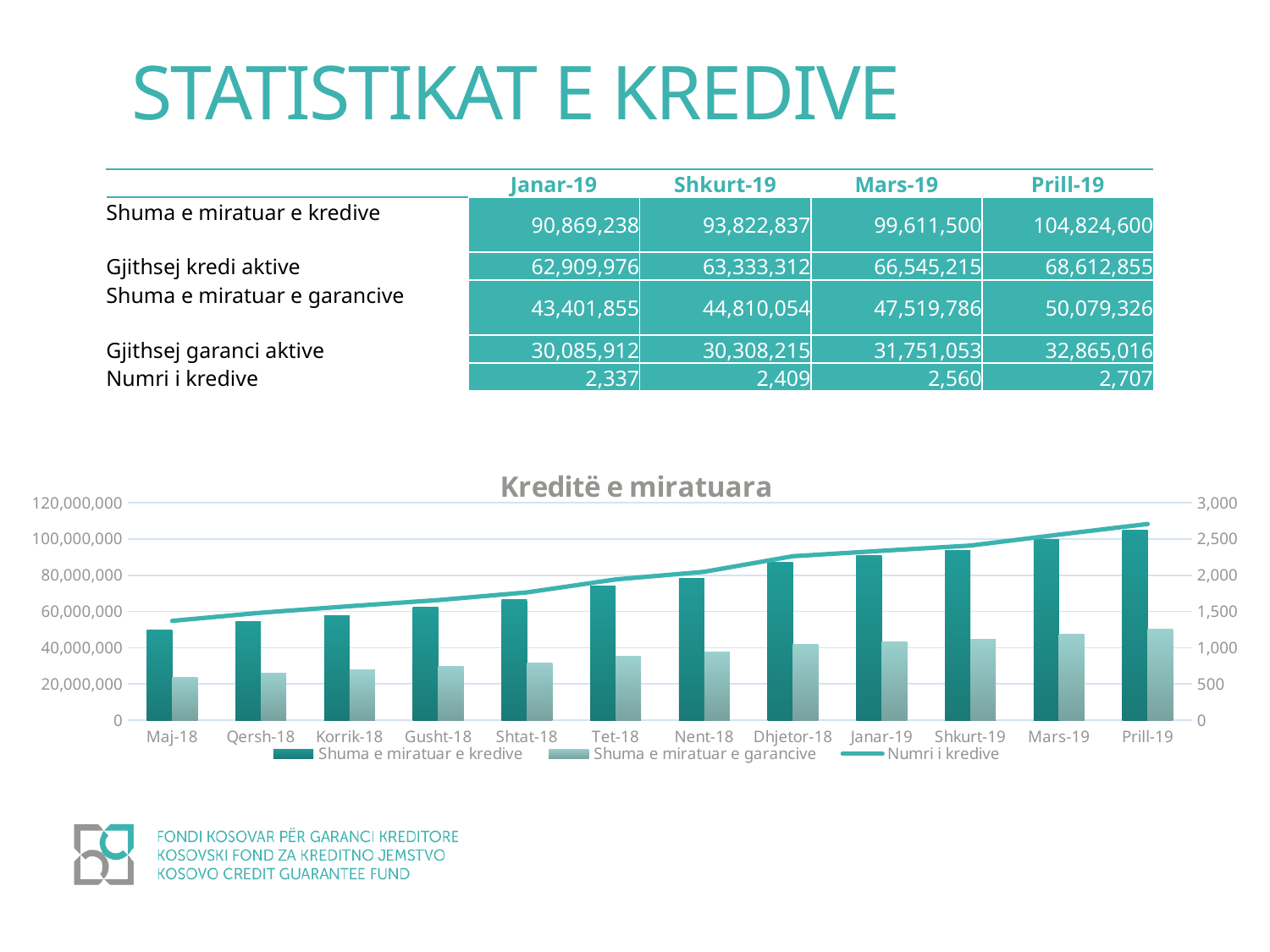
How many months are shown on the x axis of the 'Kreditë e miratuara' chart? 12 In the 'Kreditë e miratuara' chart, which month has the lowest value for 'Shuma e miratuar e garancive'? Maj-18 In the 'Kreditë e miratuara' chart, is the value for 'Shuma e miratuar e kredive' in Prill-19 greater or less than 100,000,000? greater What type of chart is shown under the title 'Kreditë e miratuara'? Bar chart with a line In the 'Kreditë e miratuara' chart, does the 'Numri i kredive' line rise or fall from Maj-18 to Prill-19? Rise In the 'Kreditë e miratuara' chart, which is larger in Korrik-18: 'Shuma e miratuar e kredive' or 'Shuma e miratuar e garancive'? Shuma e miratuar e kredive What is the value of 'Numri i kredive' for Mars-19, as shown on the slide? 2,560 What is the value of 'Shuma e miratuar e kredive' for Prill-19, as shown on the slide? 104,824,600 How many series does the legend of the 'Kreditë e miratuara' chart list? 3 In the 'Kreditë e miratuara' chart, which month has the highest value for 'Shuma e miratuar e kredive'? Prill-19